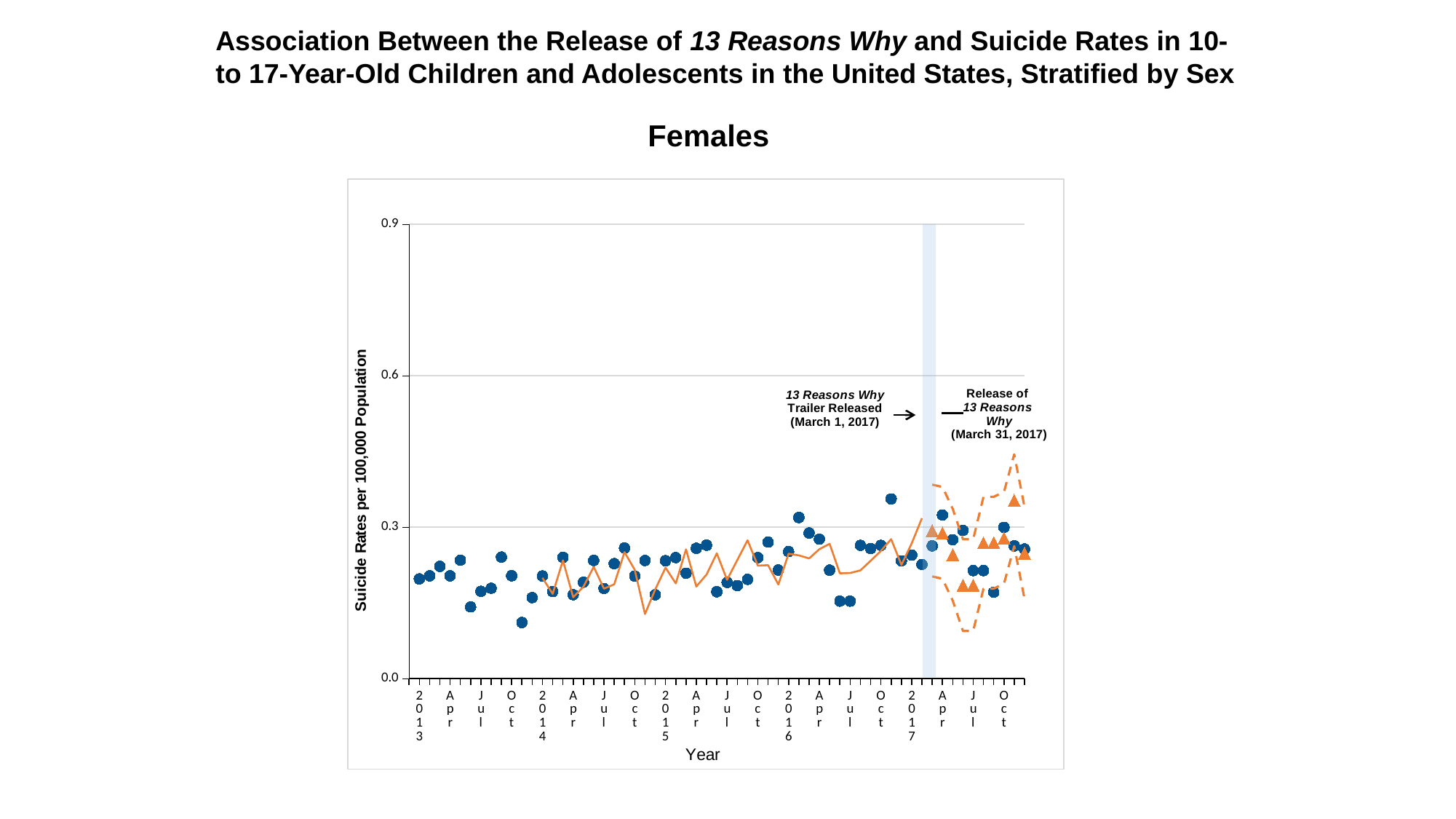
What kind of chart is shown on the slide? scatter plot What is the first year shown on the x axis? 2013 What is the highest value shown on the y axis? 0.9 Is the highest plotted value on the chart greater or less than 0.6? less Which group does the chart on the slide show data for? Females Is the value for January 2016 greater or less than 0.3? less According to the annotation on the chart, when was 13 Reasons Why released? March 31, 2017 Is the value for January 2017 greater or less than 0.3? less Do the plotted suicide rates generally rise or fall from 2013 to 2017? rise